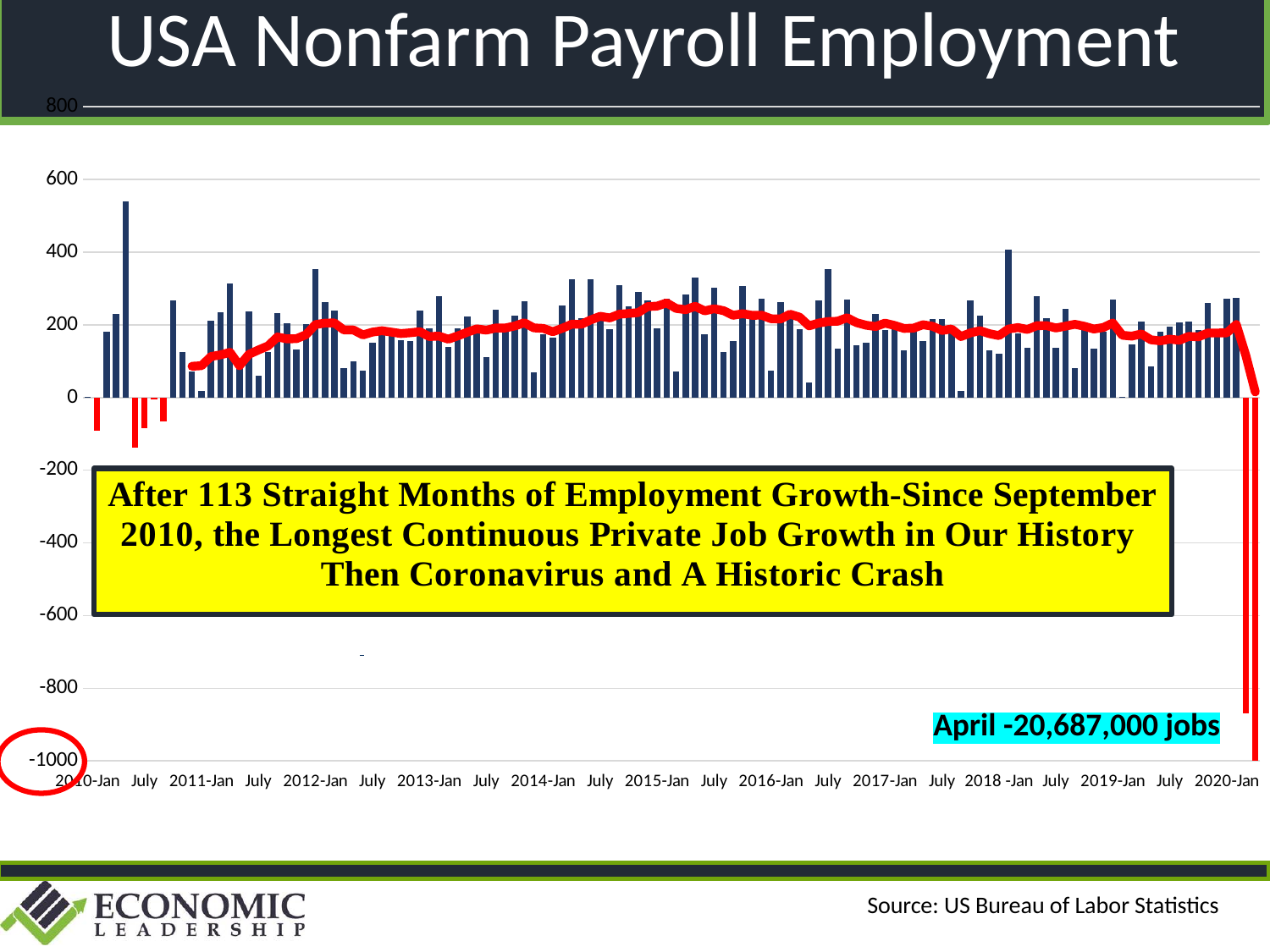
Is the tallest bar in 2010 greater or less than 600? less Does the red line rise or fall between 2010-Jan and 2015-Jan? rise What is the lowest value shown on the vertical axis? -1000 What is the title of the chart? USA Nonfarm Payroll Employment In which year does the lowest bar on the chart appear? 2020 Is the tallest bar in 2010 greater or less than 400? greater What job figure for April is printed on the chart? -20,687,000 jobs What source is cited for the chart data? US Bureau of Labor Statistics What is the highest value shown on the vertical axis? 800 Is the value for the last bar on the right (2020) greater or less than -800? less What kind of chart is shown on the slide? bar chart